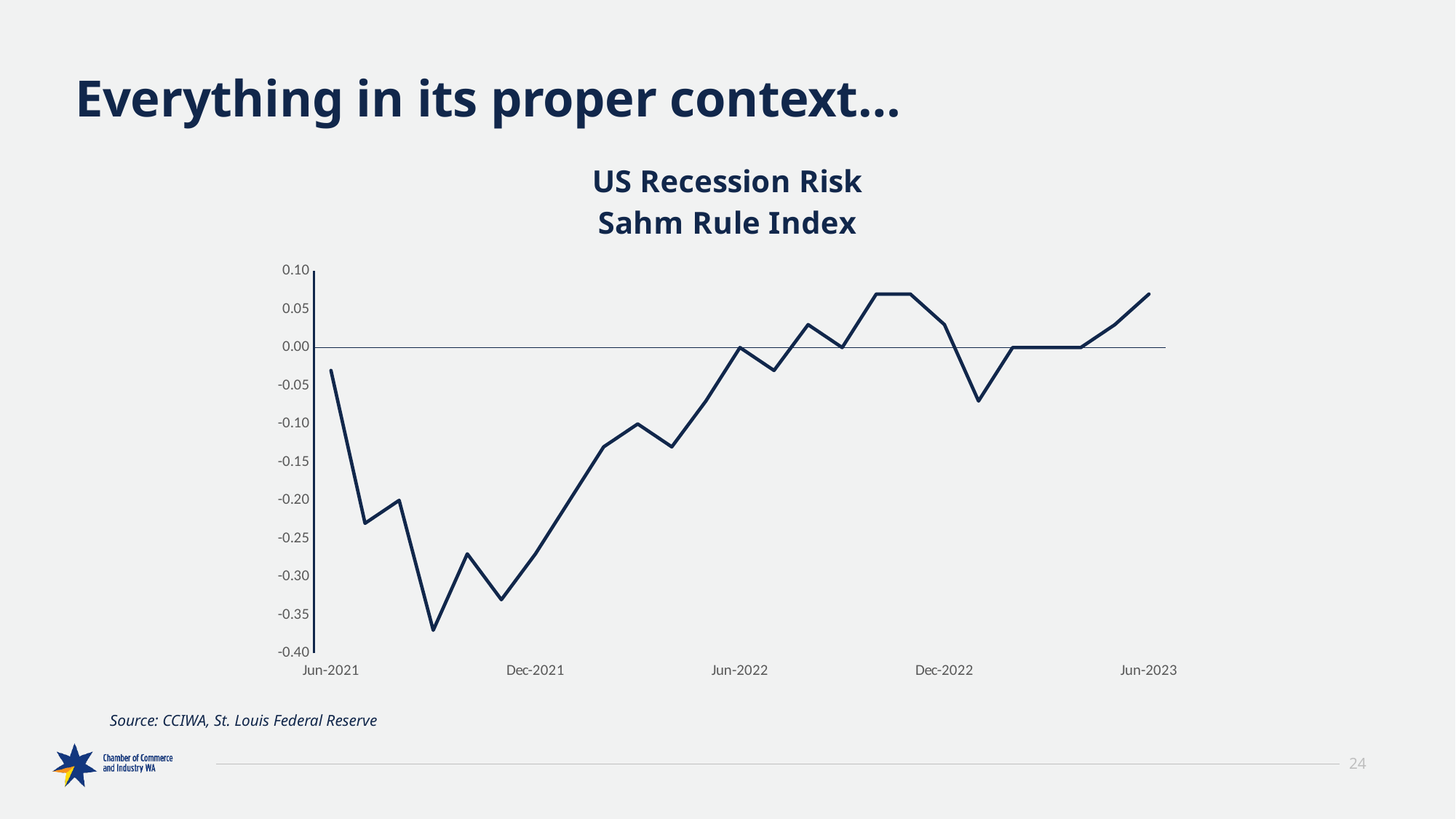
Is the value at Dec-2021 greater or less than -0.10? less What is the title of the chart? US Recession Risk Sahm Rule Index What kind of chart is shown on the slide? Line chart Of the dates labelled on the x axis, which has the lowest value? Dec-2021 Is the value at Jun-2023 greater or less than 0.00? greater Does the line generally rise or fall between Dec-2021 and Jun-2022? Rise Is the lowest point on the line greater or less than -0.30? less Of the dates labelled on the x axis, which has the highest value? Jun-2023 What source is cited for the chart? CCIWA, St. Louis Federal Reserve Which is larger, the value at Jun-2021 or the value at Dec-2021? Jun-2021